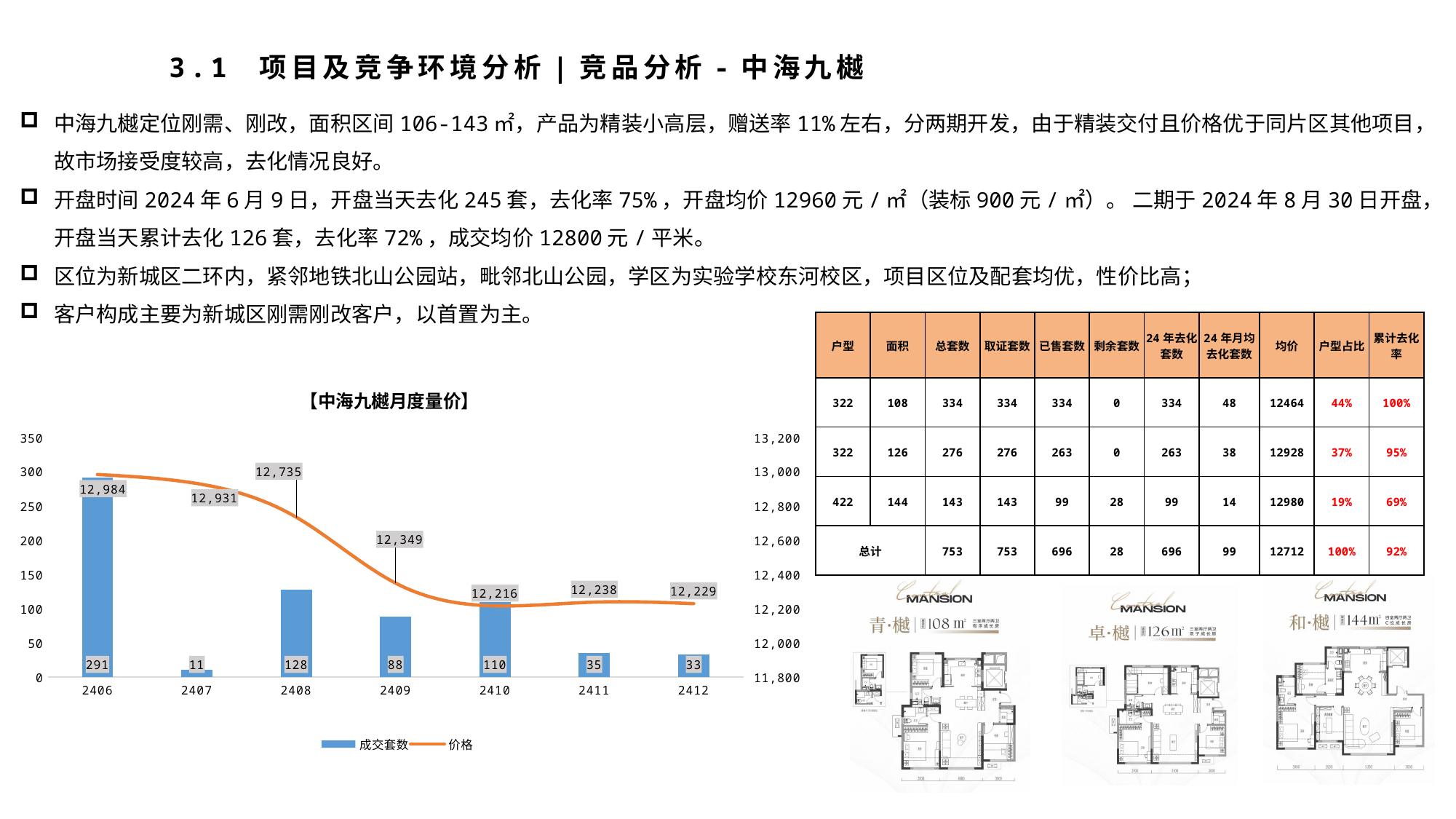
In the 【中海九樾月度量价】 chart, what is the difference in 成交套数 between 2406 and 2408? 163 In the 【中海九樾月度量价】 chart, which month has a larger 成交套数, 2409 or 2410? 2410 How many series does the legend of the 【中海九樾月度量价】 chart list? 2 In the 【中海九樾月度量价】 chart, what is the 价格 value for 2409? 12,349 In the 【中海九樾月度量价】 chart, what is the 成交套数 value for 2411? 35 In the 【中海九樾月度量价】 chart, which month has the highest 成交套数? 2406 Does the 价格 line in the 【中海九樾月度量价】 chart generally rise or fall from 2406 to 2410? fall In the 【中海九樾月度量价】 chart, which month has the highest 价格? 2406 How many months are shown on the x axis of the 【中海九樾月度量价】 chart? 7 In the 【中海九樾月度量价】 chart, which month has the lowest 成交套数? 2407 In the 【中海九樾月度量价】 chart, what is the difference in 价格 between 2407 and 2408? 196 In the 【中海九樾月度量价】 chart, what is the 成交套数 value for 2406? 291